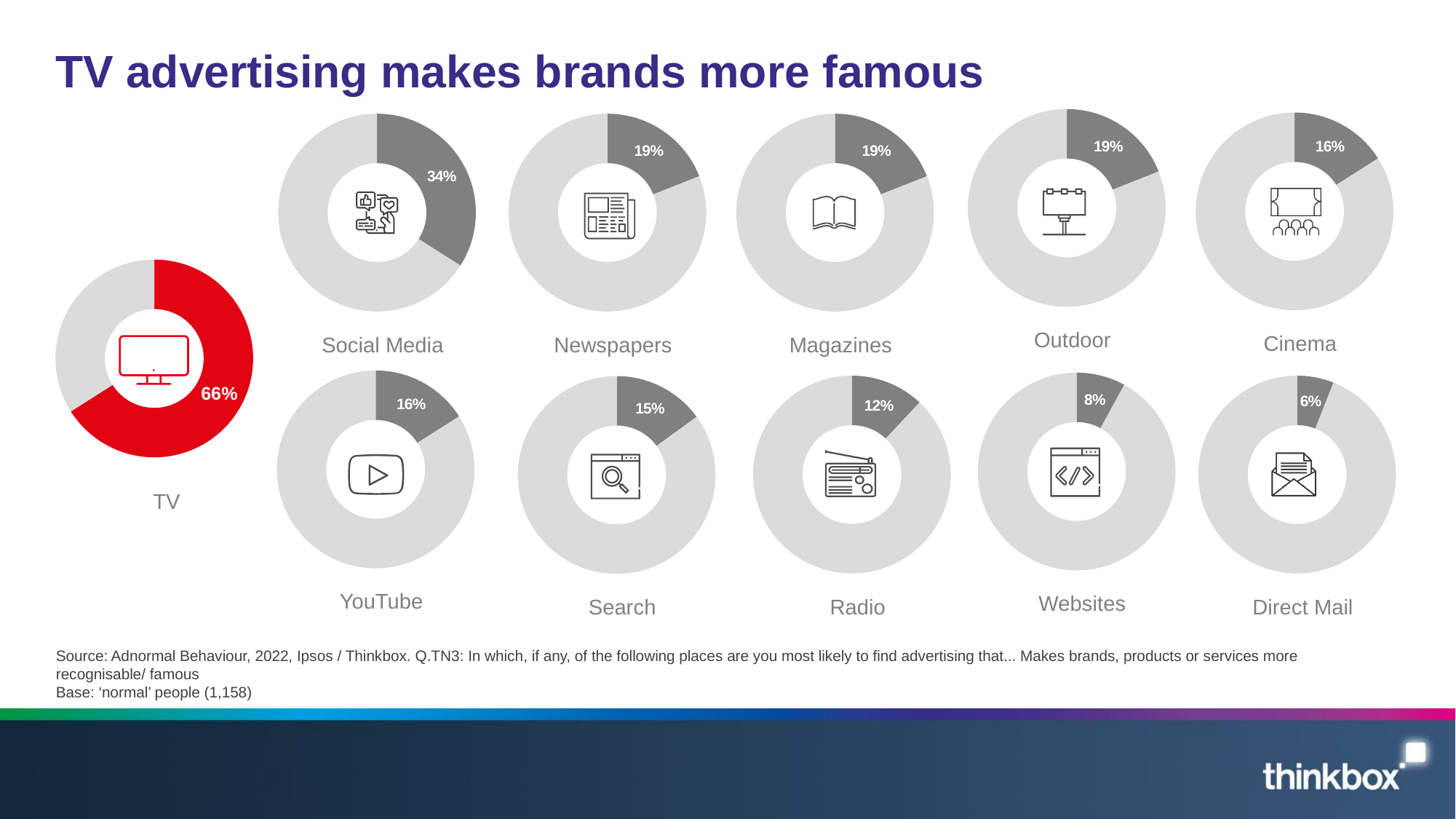
On the Radio donut chart, what percentage is shown? 12% On the TV donut chart, what percentage is shown? 66% Which donut chart on the slide is coloured red rather than grey? TV Across all the donut charts on the slide, which medium has the highest percentage? TV How many donut charts are shown on the slide? 11 On the Social Media donut chart, what percentage is shown? 34% Across all the donut charts on the slide, which medium has the lowest percentage? Direct Mail Which is larger, the percentage on the Websites donut chart or the percentage on the Search donut chart? Search What is the difference between the percentage on the TV donut chart and the percentage on the Social Media donut chart? 32% What kind of chart is used for each medium on the slide? Donut chart What is the difference between the percentage on the Cinema donut chart and the percentage on the Radio donut chart? 4% On the Direct Mail donut chart, what percentage is shown? 6%